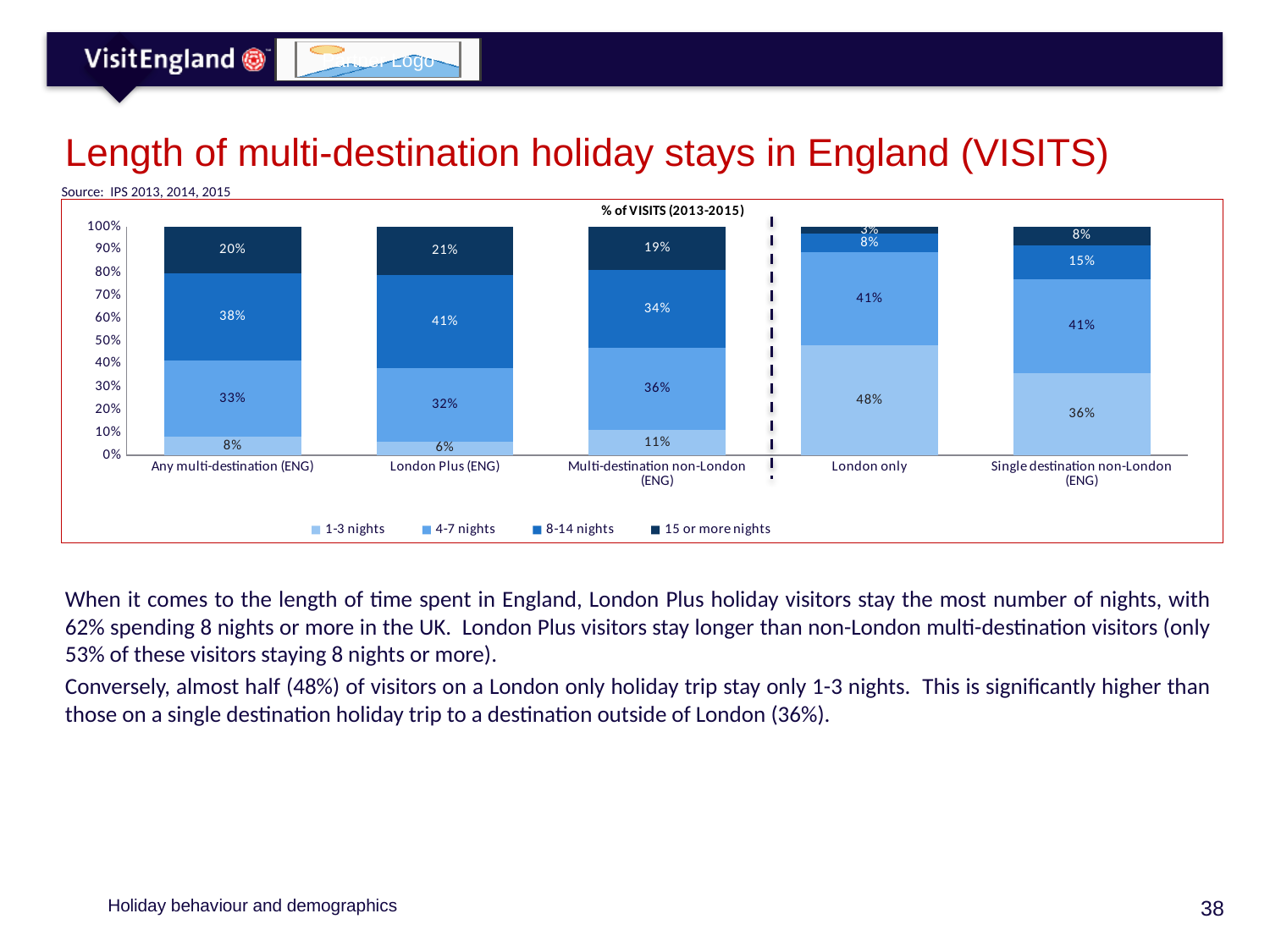
What is the title shown above the chart's plot area? % of VISITS (2013-2015) How many destination categories are shown on the x axis of the chart? 5 What kind of chart is shown on the slide? Stacked bar chart How many series does the chart legend list? 4 What is the 8-14 nights share for London Plus (ENG)? 41% What is the 4-7 nights share for Any multi-destination (ENG)? 33% Which category has the lowest 15 or more nights share? London only What is the 1-3 nights share for London only? 48% Which category has the highest 1-3 nights share? London only Which is larger: the 8-14 nights share for London Plus (ENG) or for Multi-destination non-London (ENG)? London Plus (ENG) What is the 15 or more nights share for Multi-destination non-London (ENG)? 19% What is the difference between the 1-3 nights share for London only and for Single destination non-London (ENG)? 12 percentage points